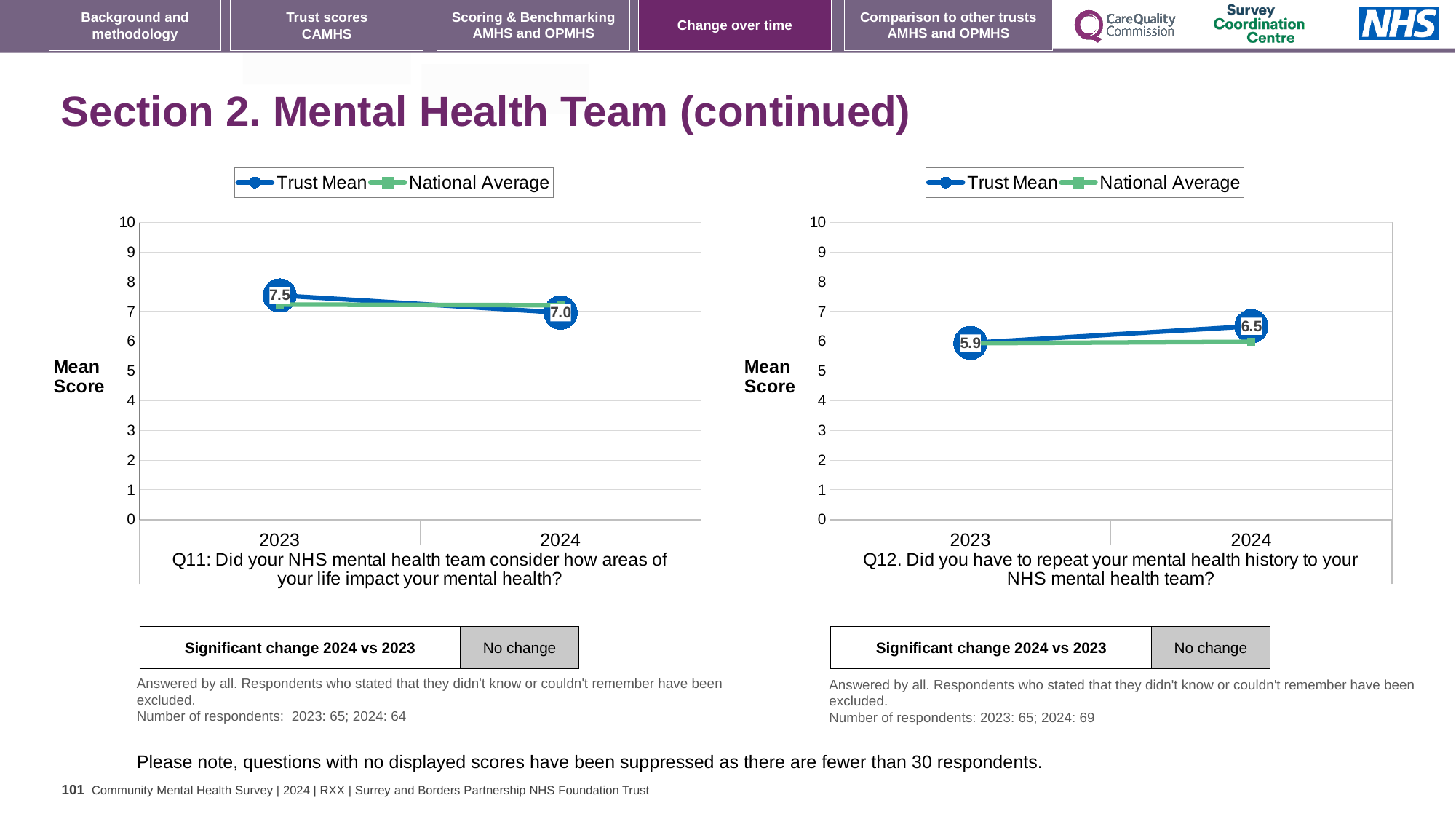
What kind of chart is the Q11 chart on the left? line chart In the Q11 chart on the left, by how much did the Trust Mean change from 2023 to 2024? 0.5 In the Q11 chart on the left, does the Trust Mean rise or fall from 2023 to 2024? fall In the Q12 chart on the right, what is the difference between the Trust Mean for 2024 and 2023? 0.6 In the Q12 chart on the right, does the Trust Mean rise or fall from 2023 to 2024? rise In the Q12 chart on the right, is the Trust Mean for 2023 greater or less than 7? less In the Q11 chart on the left, what is the Trust Mean score for 2024? 7.0 In the Q11 chart on the left, which year has the higher Trust Mean score? 2023 In the Q12 chart on the right, what is the Trust Mean score for 2024? 6.5 In the Q11 chart on the left, what is the Trust Mean score for 2023? 7.5 How many series does the legend of the Q12 chart on the right list? 2 In the Q12 chart on the right, what is the Trust Mean score for 2023? 5.9